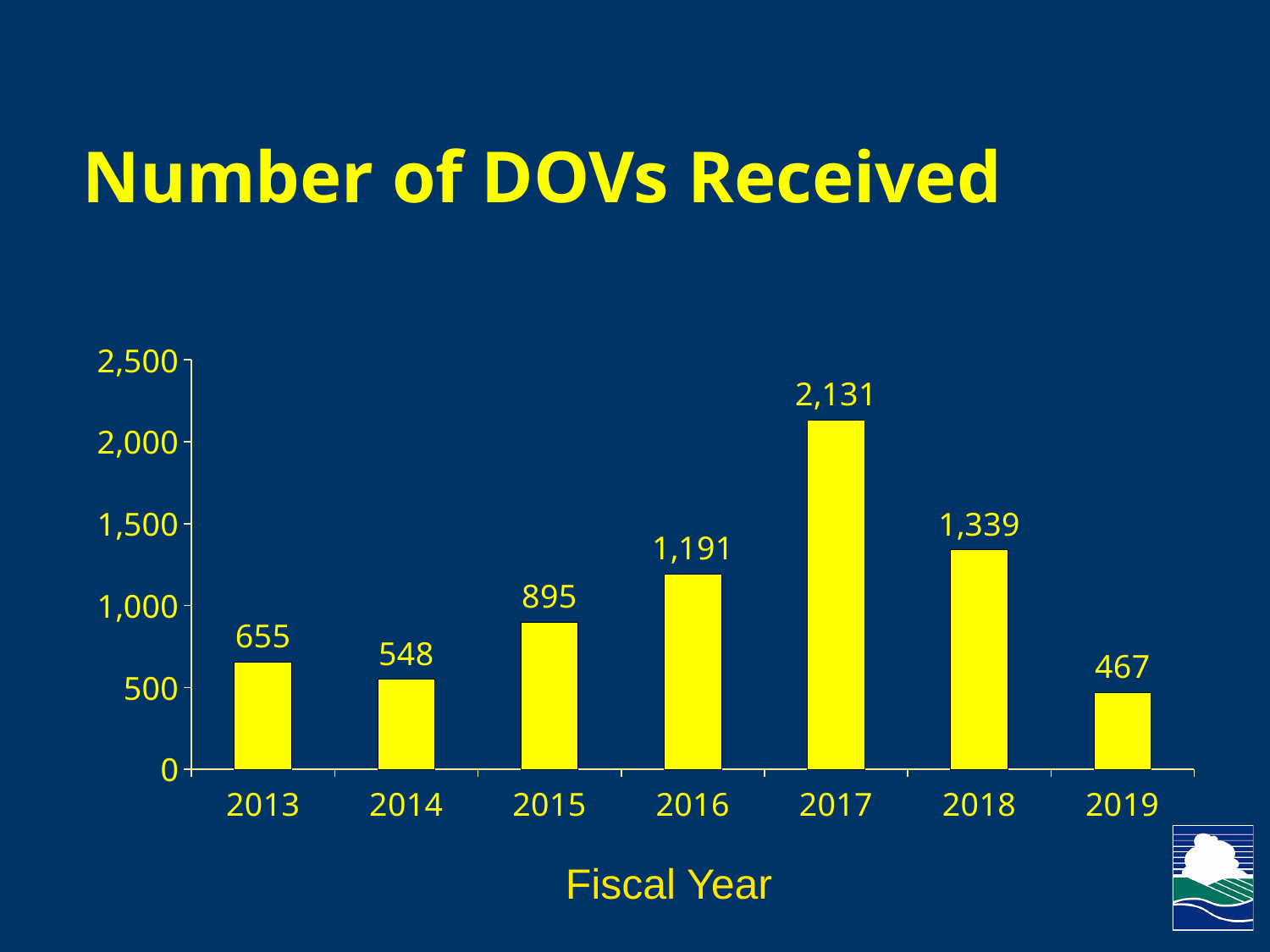
What is the label of the x axis? Fiscal Year What is the value shown for fiscal year 2014? 548 Is the value for 2018 greater or less than 1,000? greater Which fiscal year has the highest number of DOVs received? 2017 How many DOVs were received in fiscal year 2019? 467 How many fiscal years are shown on the chart? 7 How many DOVs were received in fiscal year 2017? 2,131 What is the difference between the values for 2016 and 2015? 296 What kind of chart is shown on the slide? bar chart What is the difference between the number of DOVs received in 2017 and in 2018? 792 Which fiscal year has the lowest number of DOVs received? 2019 Which fiscal year had more DOVs received, 2013 or 2014? 2013